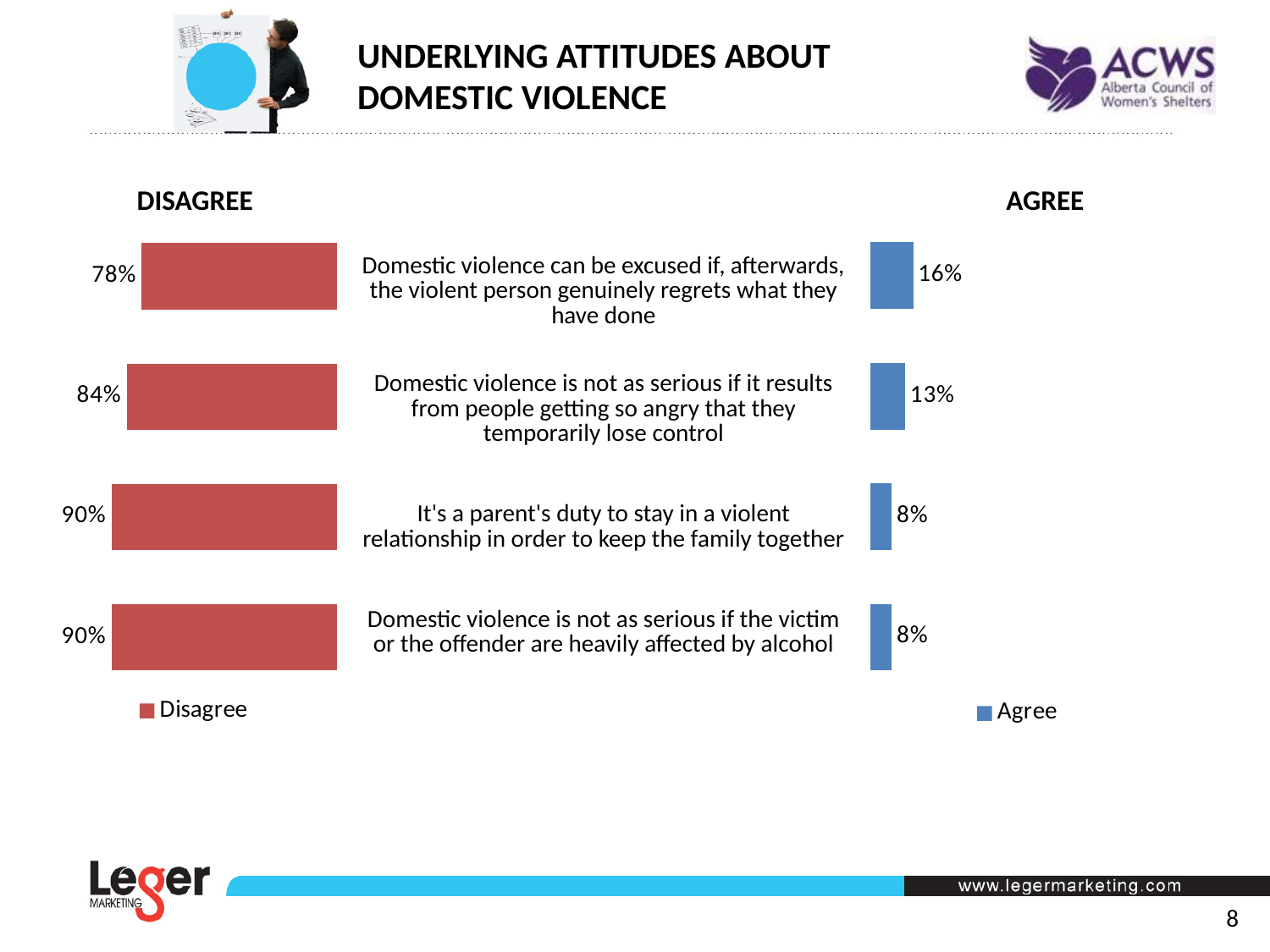
What kind of chart is shown on the slide? Bar chart Which statement has the lowest Disagree percentage? Domestic violence can be excused if, afterwards, the violent person genuinely regrets what they have done What percentage agree that domestic violence can be excused if, afterwards, the violent person genuinely regrets what they have done? 16% Which is larger: the Agree percentage for the statement about the violent person genuinely regretting what they have done, or the Agree percentage for the statement about being heavily affected by alcohol? The statement about the violent person genuinely regretting what they have done Which statement has the highest Agree percentage? Domestic violence can be excused if, afterwards, the violent person genuinely regrets what they have done What percentage agree that it's a parent's duty to stay in a violent relationship in order to keep the family together? 8% What percentage disagree that domestic violence can be excused if, afterwards, the violent person genuinely regrets what they have done? 78% How many statements are shown in the chart? 4 How many series does the chart's legend list? 2 What is the difference between the Disagree and Agree percentages for the statement that domestic violence is not as serious if it results from people getting so angry that they temporarily lose control? 71% What percentage disagree that domestic violence is not as serious if it results from people getting so angry that they temporarily lose control? 84% What colour are the Disagree bars? Red